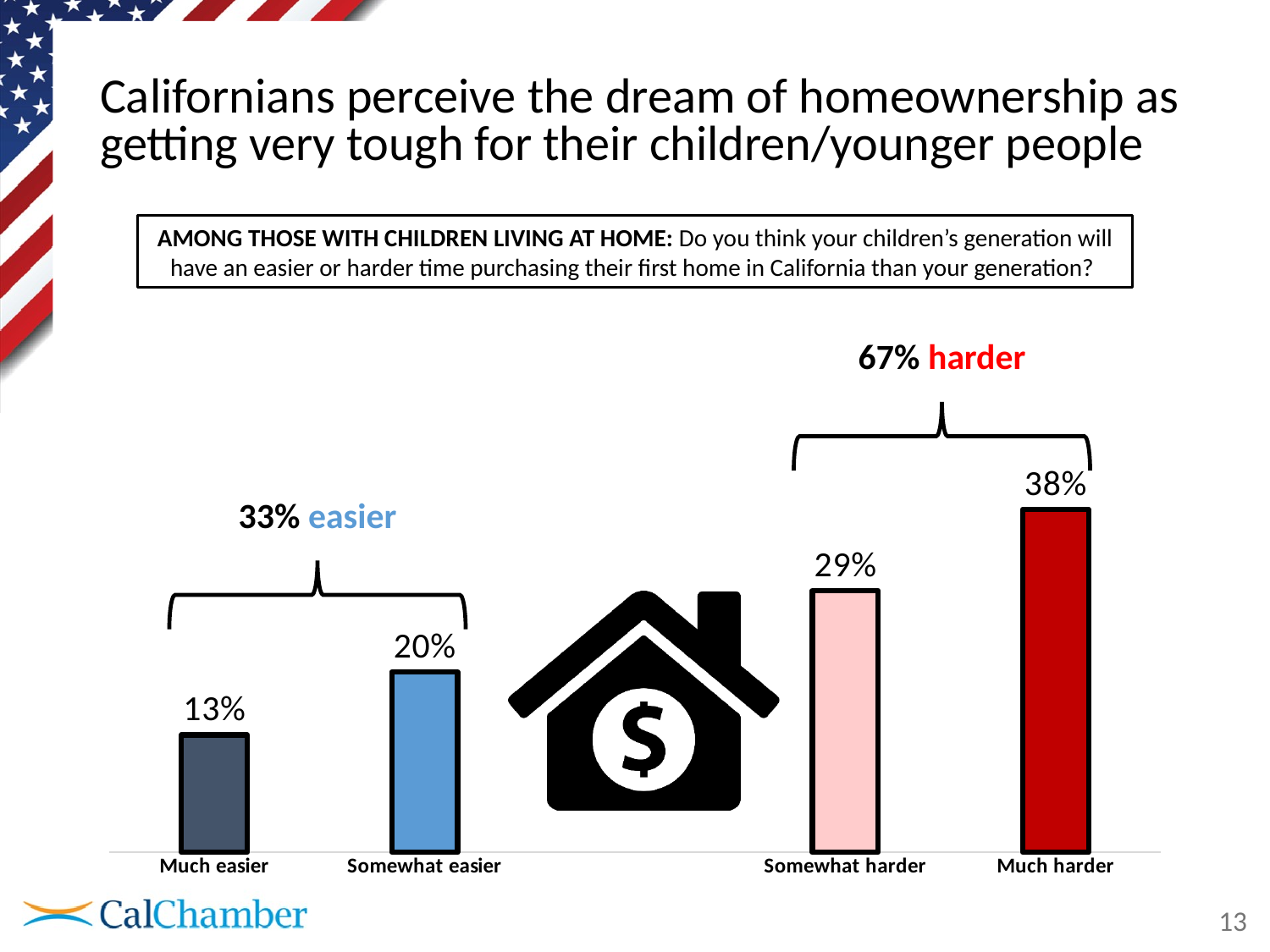
Which category has the highest value? Much harder What is the value for the 'Somewhat harder' category? 29% What is the difference between the 'Much harder' and 'Much easier' values? 25% What is the value for the 'Somewhat easier' category? 20% What percentage of respondents said their children's generation will have a much harder time purchasing their first home? 38% Which is larger, the value for 'Somewhat harder' or the value for 'Somewhat easier'? Somewhat harder What is the value for the 'Much easier' category? 13% What combined percentage is labelled as 'harder' on the chart? 67% Which category has the lowest value? Much easier What kind of chart is shown on the slide? Bar chart How many categories are shown on the chart? 4 What combined percentage is labelled as 'easier' on the chart? 33%